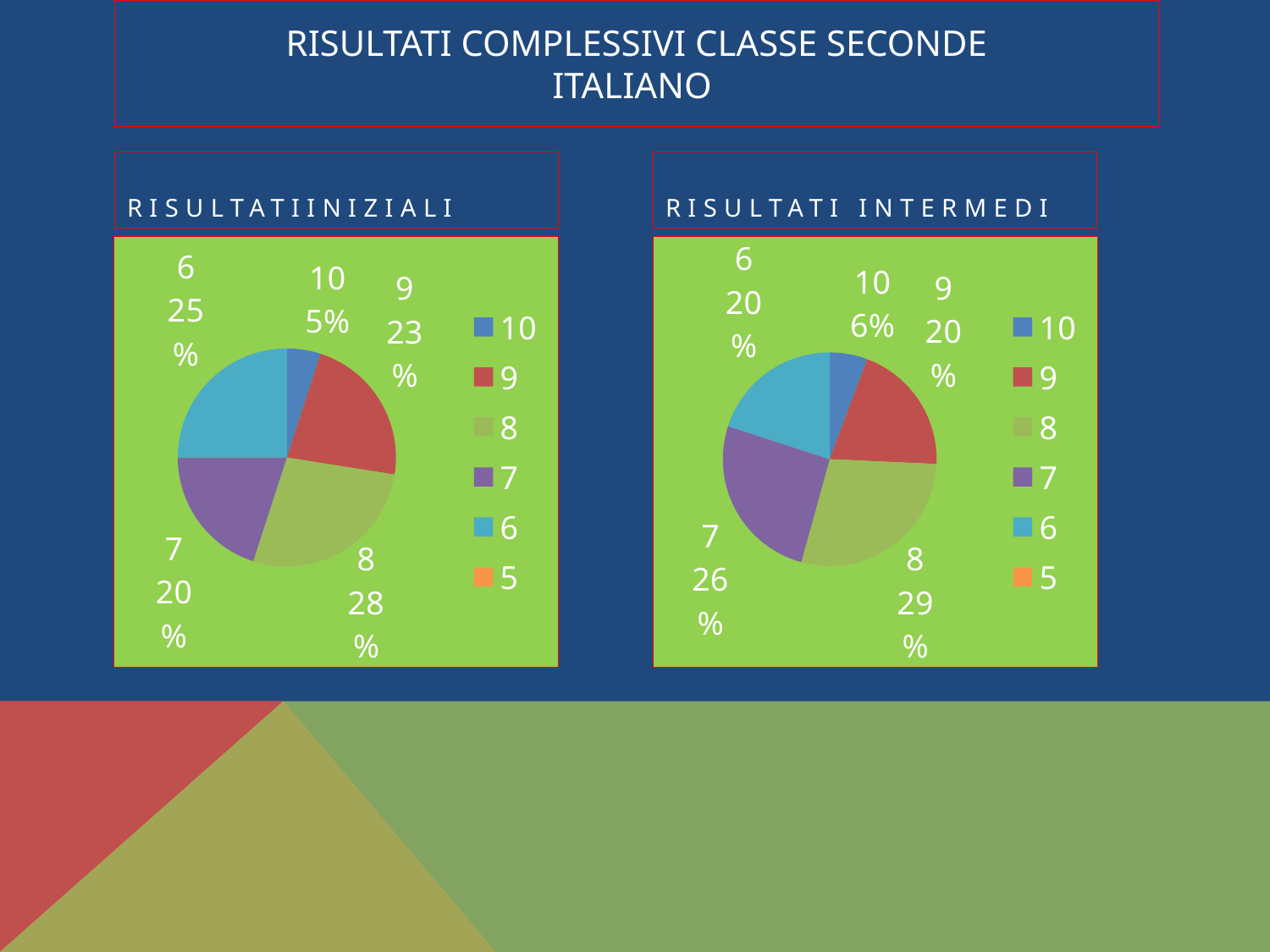
In the RISULTATI INTERMEDI chart, what share does grade 7 have? 26% How many entries does the legend of the RISULTATI INTERMEDI chart list? 6 In the RISULTATI INIZIALI chart, what share does grade 10 have? 5% In the RISULTATI INIZIALI chart, which is larger, the share of grade 9 or the share of grade 6? 6 In the RISULTATI INTERMEDI chart, what share does grade 9 have? 20% In the RISULTATI INTERMEDI chart, which grade has the smallest slice? 10 In the RISULTATI INTERMEDI chart, what is the difference between the shares of grade 8 and grade 10? 23% In the RISULTATI INIZIALI chart, what is the difference between the shares of grade 6 and grade 7? 5% In the RISULTATI INIZIALI chart, what share does grade 8 have? 28% What is the title of the chart on the right side of the slide? RISULTATI INTERMEDI In the RISULTATI INIZIALI chart, which grade has the largest slice? 8 What type of chart is used for RISULTATI INIZIALI? Pie chart